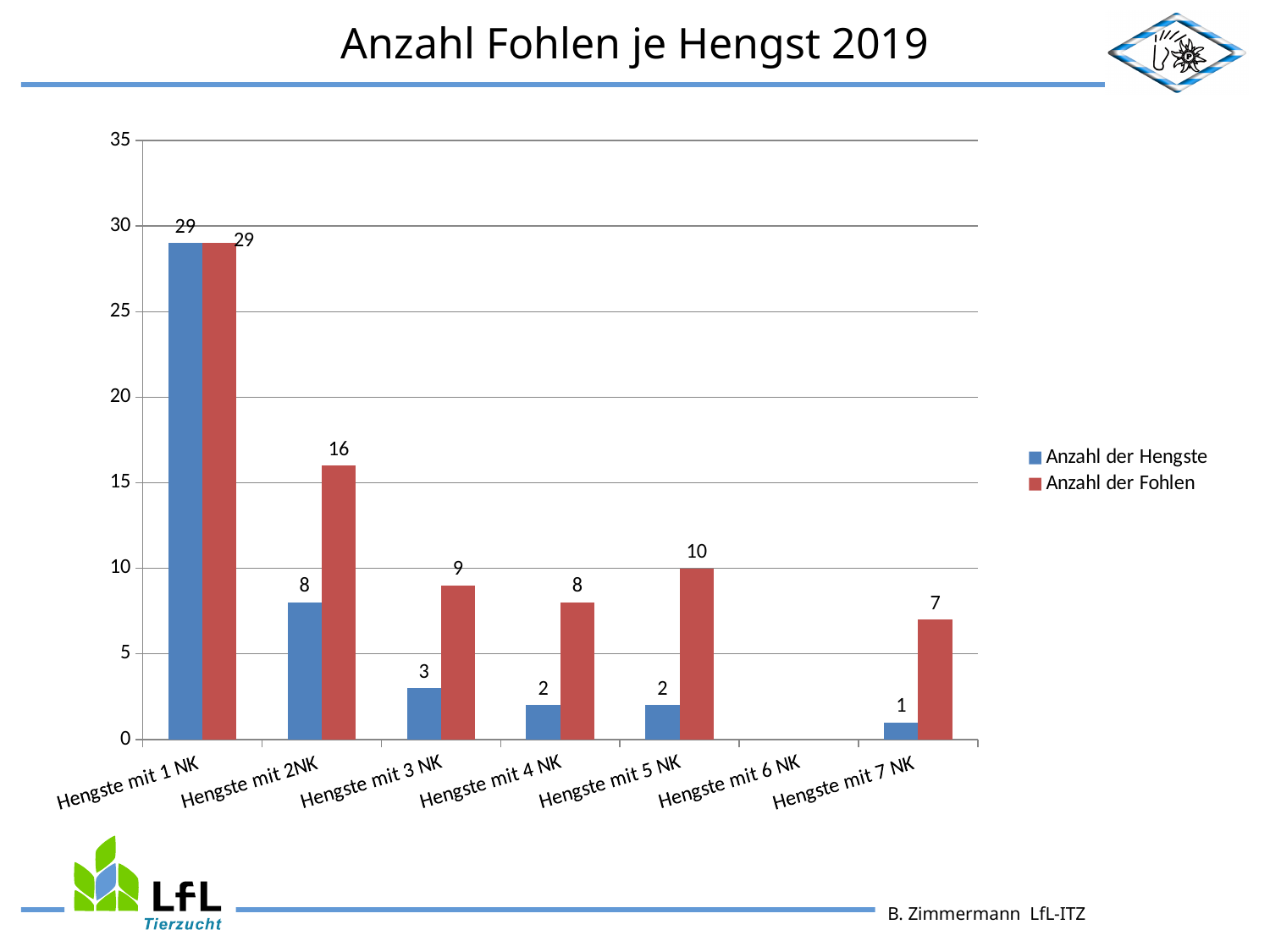
What is the difference between Anzahl der Fohlen and Anzahl der Hengste for Hengste mit 5 NK? 8 How many categories are shown on the x axis? 7 What is the value of Anzahl der Hengste for Hengste mit 3 NK? 3 Which category has the highest value for Anzahl der Fohlen? Hengste mit 1 NK Which category with a plotted bar has the lowest value for Anzahl der Hengste? Hengste mit 7 NK How many series does the legend list? 2 What is the title of the chart? Anzahl Fohlen je Hengst 2019 Is the value of Anzahl der Fohlen for Hengste mit 2NK greater or less than 15? greater What kind of chart is shown on the slide? bar chart What is the value of Anzahl der Fohlen for Hengste mit 7 NK? 7 Which is larger for Hengste mit 4 NK: Anzahl der Hengste or Anzahl der Fohlen? Anzahl der Fohlen What is the value of Anzahl der Fohlen for Hengste mit 2NK? 16